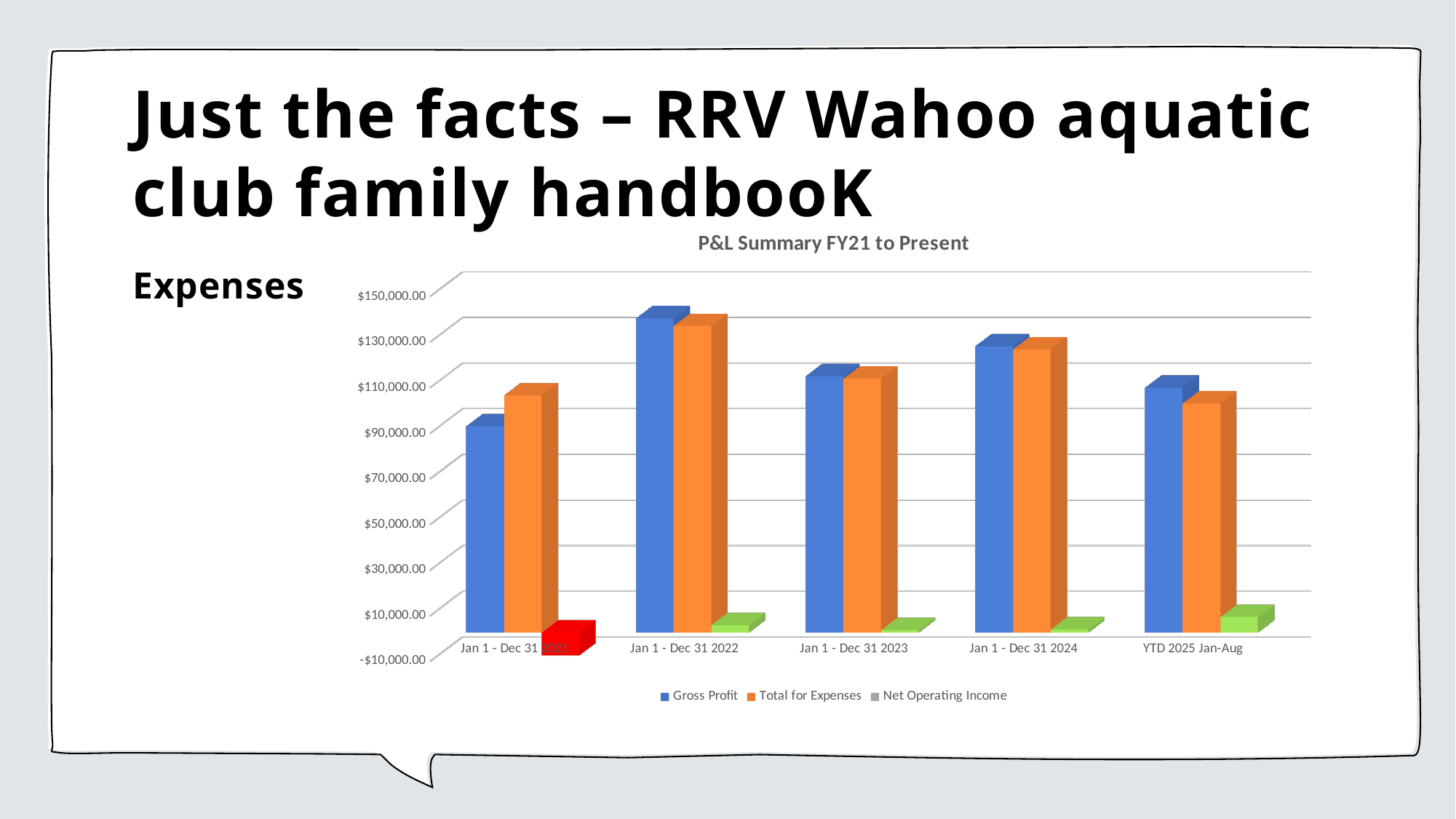
In which period is Gross Profit the highest? Jan 1 - Dec 31 2022 For Jan 1 - Dec 31 2021, which is larger: Gross Profit or Total for Expenses? Total for Expenses Is the Net Operating Income for Jan 1 - Dec 31 2021 greater or less than $10,000.00? less How many time periods (categories) are shown on the x axis? 5 What kind of chart is shown on the slide? bar chart In which period is Gross Profit the lowest? Jan 1 - Dec 31 2021 Which series is shown in orange in the legend? Total for Expenses Is the Gross Profit for Jan 1 - Dec 31 2022 greater or less than $130,000.00? greater How many series does the chart legend list? 3 What is the title of the chart? P&L Summary FY21 to Present Is the Total for Expenses for YTD 2025 Jan-Aug greater or less than $110,000.00? less